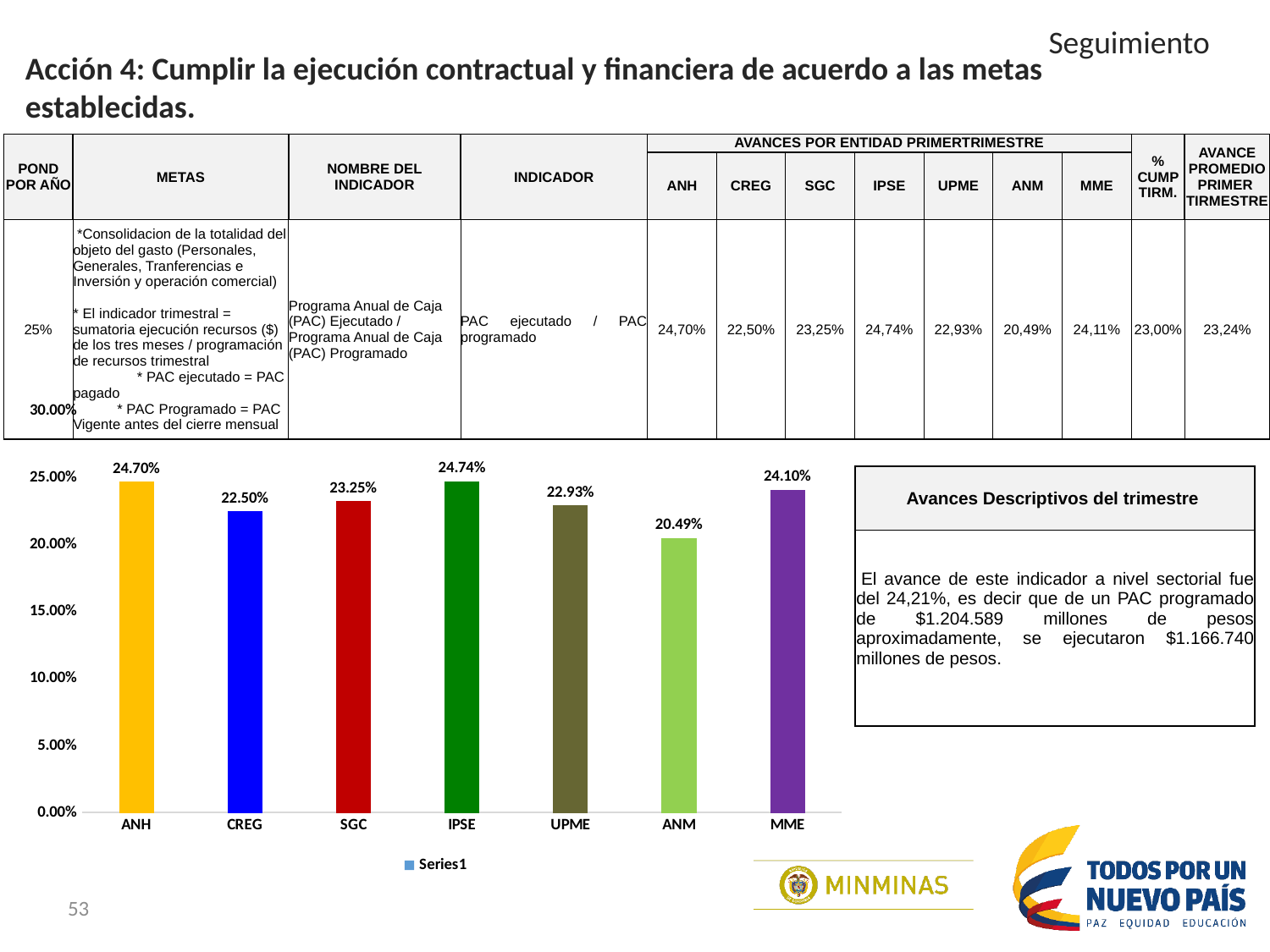
How many entities are shown on the x axis of the bar chart? 7 What is the value shown for MME in the bar chart? 24.10% How many series does the legend of the bar chart list? 1 Which entity has the lowest value in the bar chart? ANM What type of chart is shown on the slide? Bar chart What is the value shown for ANM in the bar chart? 20.49% What is the value shown for IPSE in the bar chart? 24.74% Is the value for ANM in the bar chart greater or less than 25.00%? less Which is larger in the bar chart, the value for SGC or the value for ANM? SGC What is the difference between the values for IPSE and CREG in the bar chart? 2.24 percentage points What is the value shown for ANH in the bar chart? 24.70% What is the difference between the values for ANH and ANM in the bar chart? 4.21 percentage points